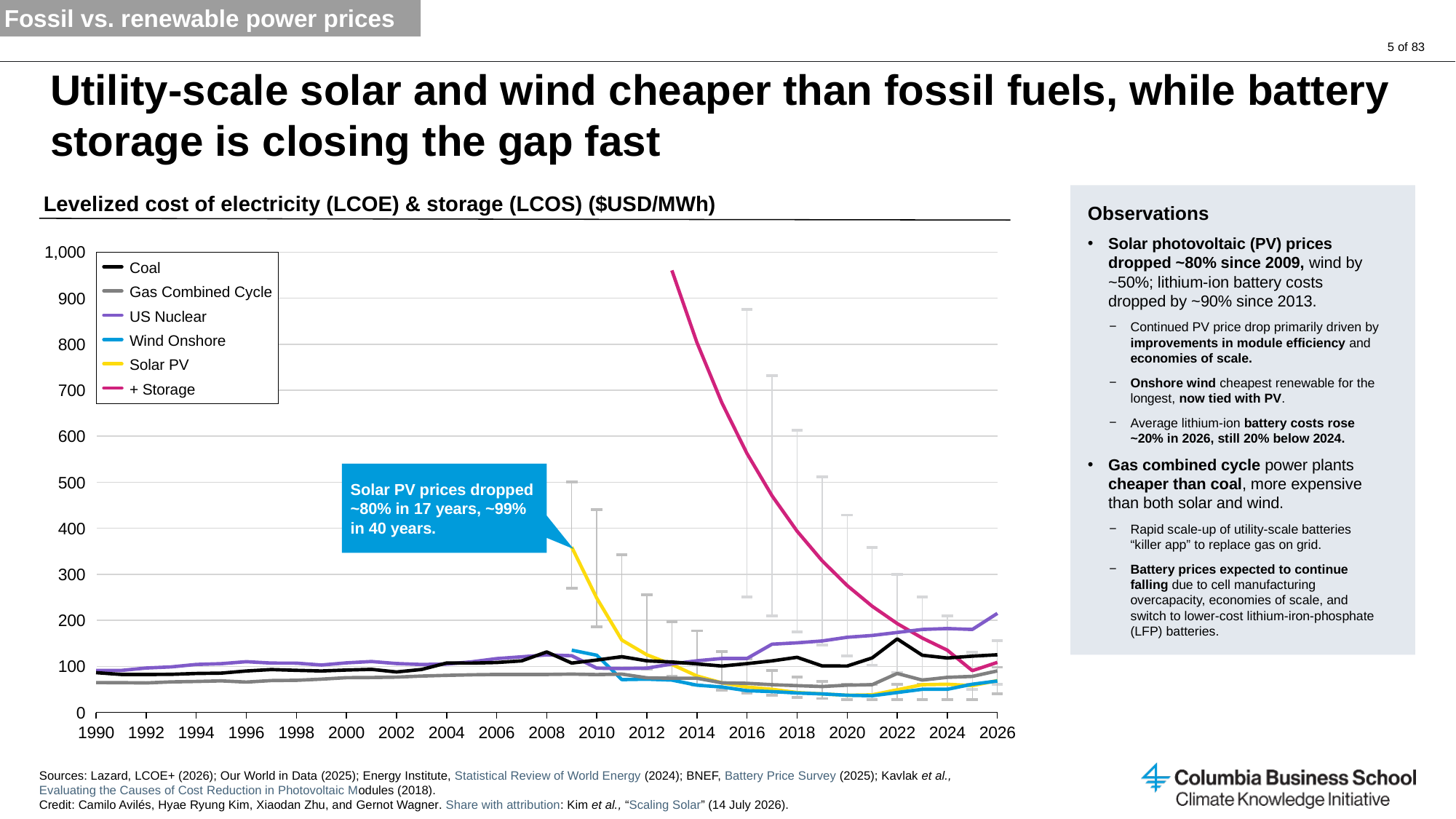
Is the value for Coal in 2022 greater or less than 200? less Which series has the highest value in 2026? US Nuclear What kind of chart is shown on the slide? line chart What is the title of the chart? Levelized cost of electricity (LCOE) & storage (LCOS) ($USD/MWh) In 2026, which is larger: US Nuclear or Gas Combined Cycle? US Nuclear Does the + Storage line rise or fall from 2013 to 2025? fall Which colour is used for the Solar PV line? yellow Which series reaches the highest value anywhere on the chart? + Storage Does the Solar PV line rise or fall from 2009 to 2026? fall How many series does the chart legend list? 6 Is the value for Wind Onshore in 2020 greater or less than 100? less Is the value for + Storage in 2013 greater or less than 900? greater